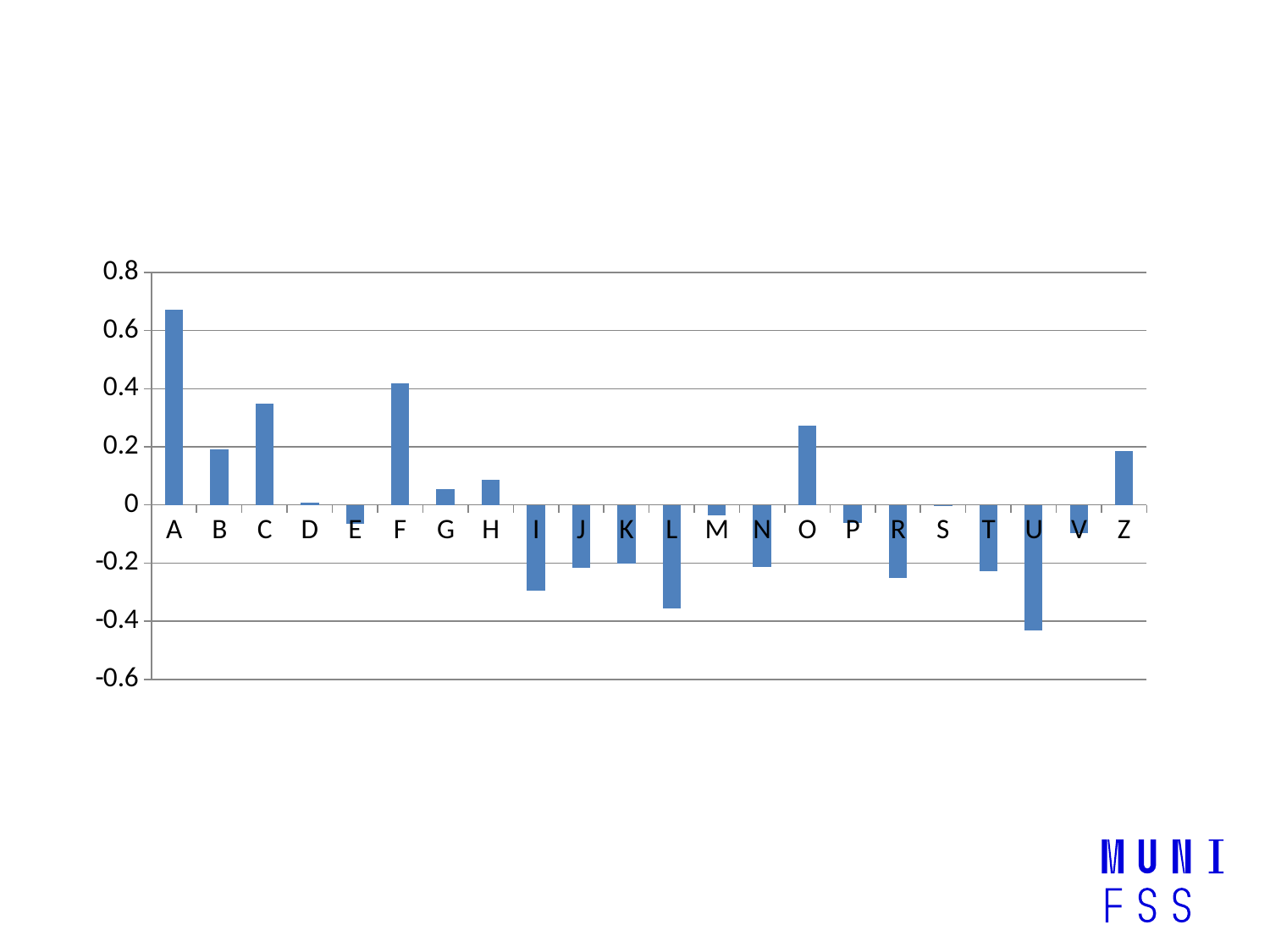
What kind of chart is shown on the slide? bar chart Is the value for L greater or less than -0.2? less How many categories are shown on the x axis? 22 Which is larger, the value for L or the value for U? L Which is larger, the value for C or the value for O? C What is the highest value shown on the vertical axis? 0.8 Is the value for U greater or less than -0.4? less Is the value for O greater or less than 0.2? greater Which category has the lowest value? U Which category has the highest value? A